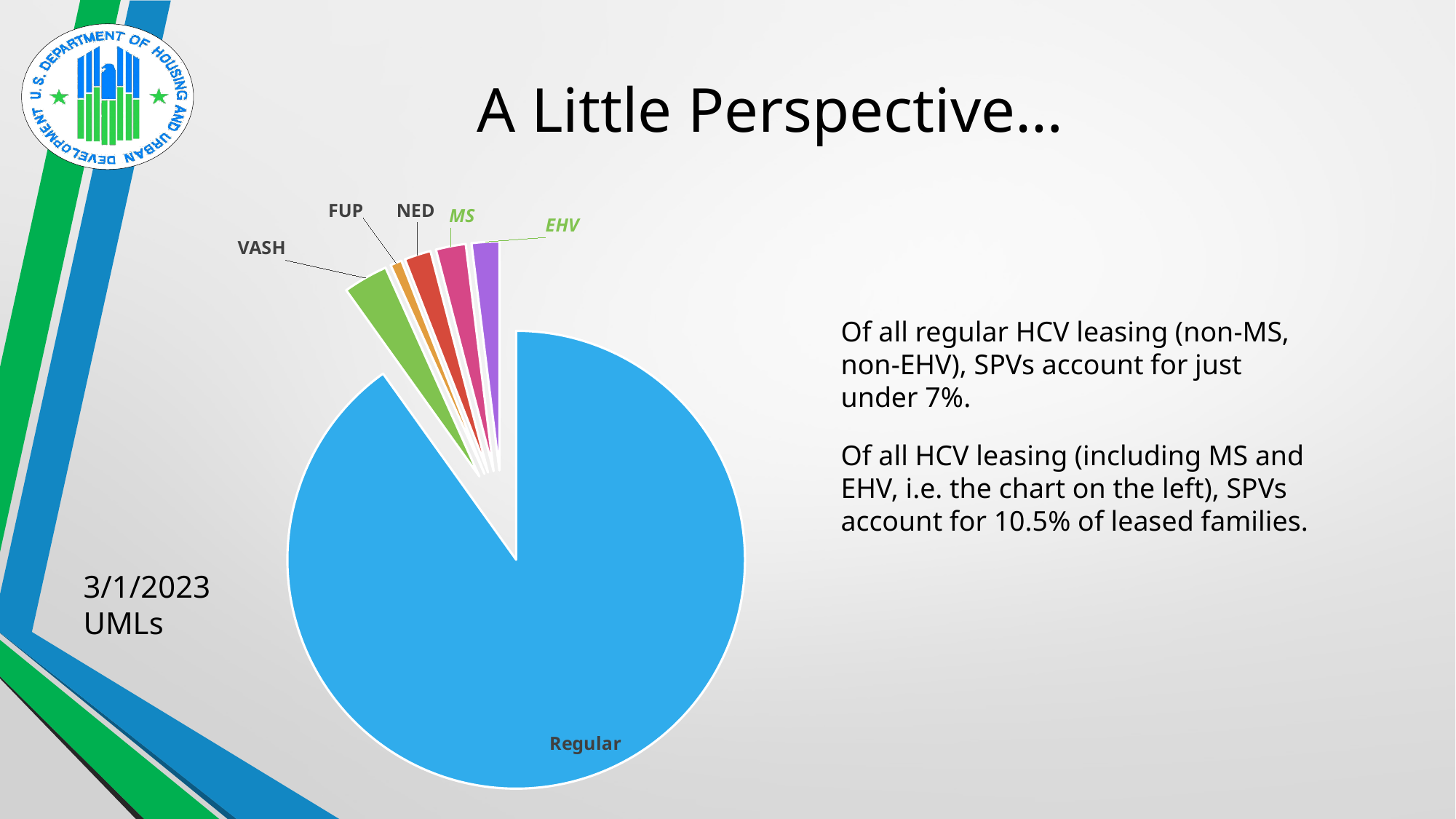
How many slices does the pie chart have? 6 Which slice of the pie chart is the largest? Regular Which is larger in the pie chart, VASH or FUP? VASH What colour is the Regular slice of the pie chart? blue Which is larger in the pie chart, VASH or NED? VASH Which is larger in the pie chart, Regular or VASH? Regular What is the title of the slide containing the pie chart? A Little Perspective… Which slice of the pie chart is the smallest? FUP What kind of chart is shown on the slide? pie chart Which slice of the pie chart is the largest among the non-Regular slices? VASH